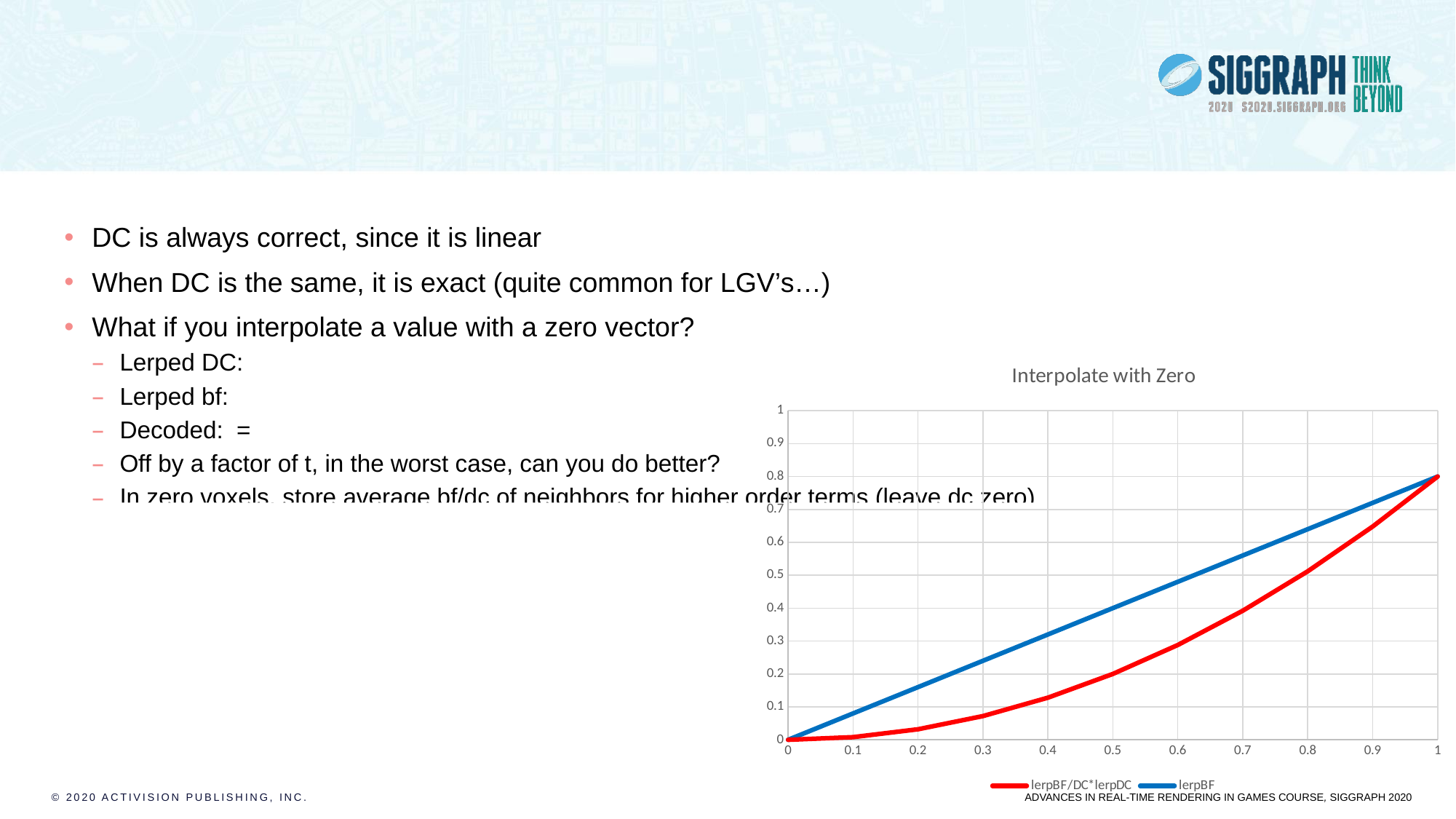
What is the value of the lerpBF series at x = 0.5? 0.4 What is the title of the chart? Interpolate with Zero How many series does the chart's legend list? 2 What kind of chart is shown on the slide? line chart At x = 0.5, which series has the larger value, lerpBF or lerpBF/DC*lerpDC? lerpBF Is the value of the lerpBF/DC*lerpDC series at x = 0.3 greater or less than 0.1? less Do the values of the lerpBF/DC*lerpDC series rise or fall as x increases from 0 to 1? rise Do the values of the lerpBF series rise or fall as x increases from 0 to 1? rise Which series is drawn in red in the chart? lerpBF/DC*lerpDC What is the value of the lerpBF series at x = 1? 0.8 What is the value of the lerpBF series at x = 0? 0 Is the value of the lerpBF series at x = 0.8 greater or less than 0.6? greater